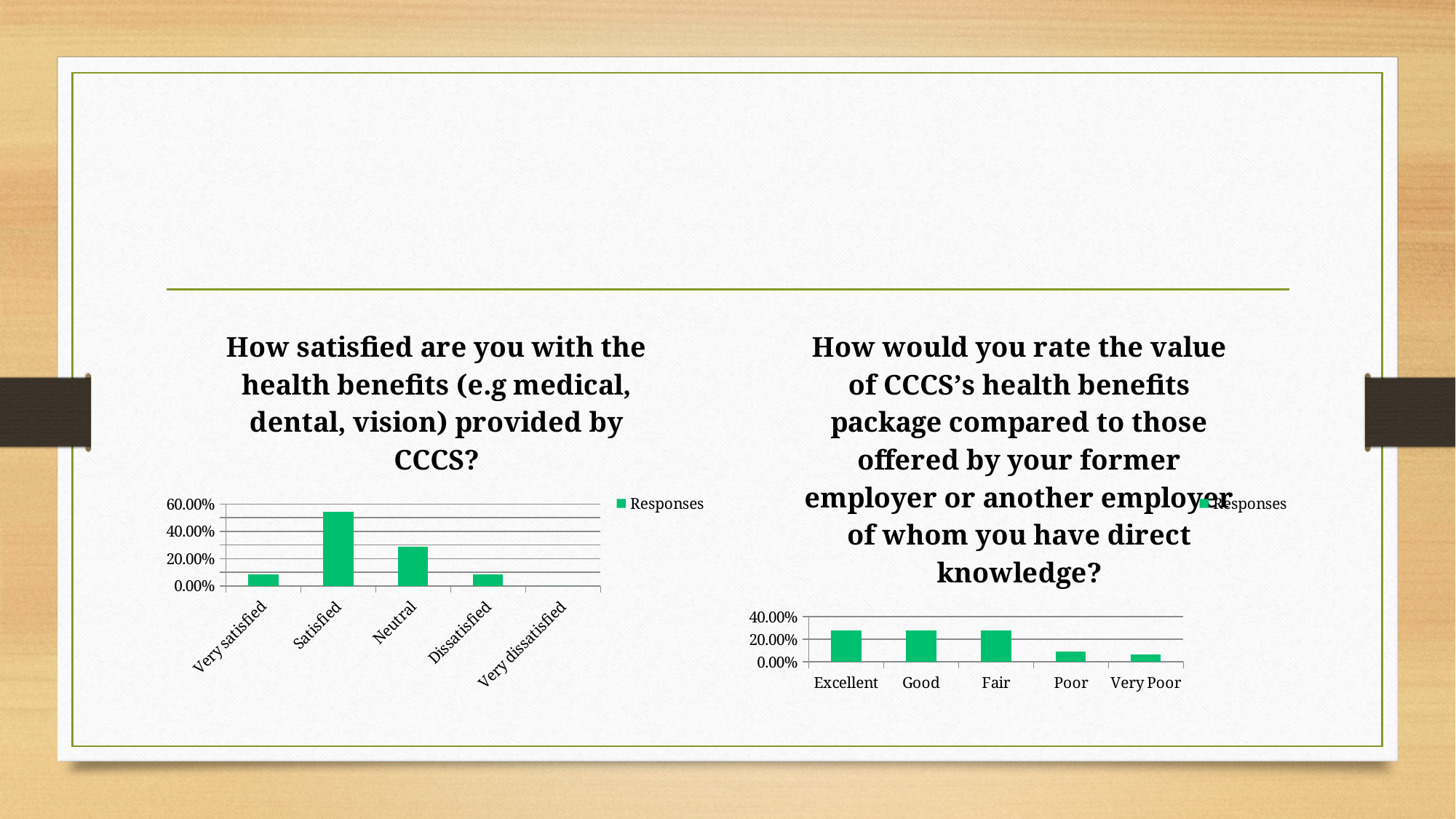
In the right chart about rating the value of CCCS's health benefits package, is the value for Poor greater or less than 20.00%? less In the right chart about rating the value of CCCS's health benefits package, which is larger, the value for Fair or the value for Very Poor? Fair In the left chart about satisfaction with health benefits, is the value for Neutral greater or less than 40.00%? less How many series does the legend list for the right chart about rating the value of CCCS's health benefits package? 1 In the left chart about satisfaction with health benefits, which category has the highest value? Satisfied In the left chart about satisfaction with health benefits, is the value for Satisfied greater or less than 40.00%? greater What is the legend entry shown for the left chart about satisfaction with health benefits? Responses In the left chart about satisfaction with health benefits, which category has the lowest value? Very dissatisfied What kind of chart is the left chart, 'How satisfied are you with the health benefits...provided by CCCS?'? bar chart How many categories are shown on the x axis of the left chart about satisfaction with health benefits? 5 In the left chart about satisfaction with health benefits, which is larger, the value for Neutral or the value for Dissatisfied? Neutral